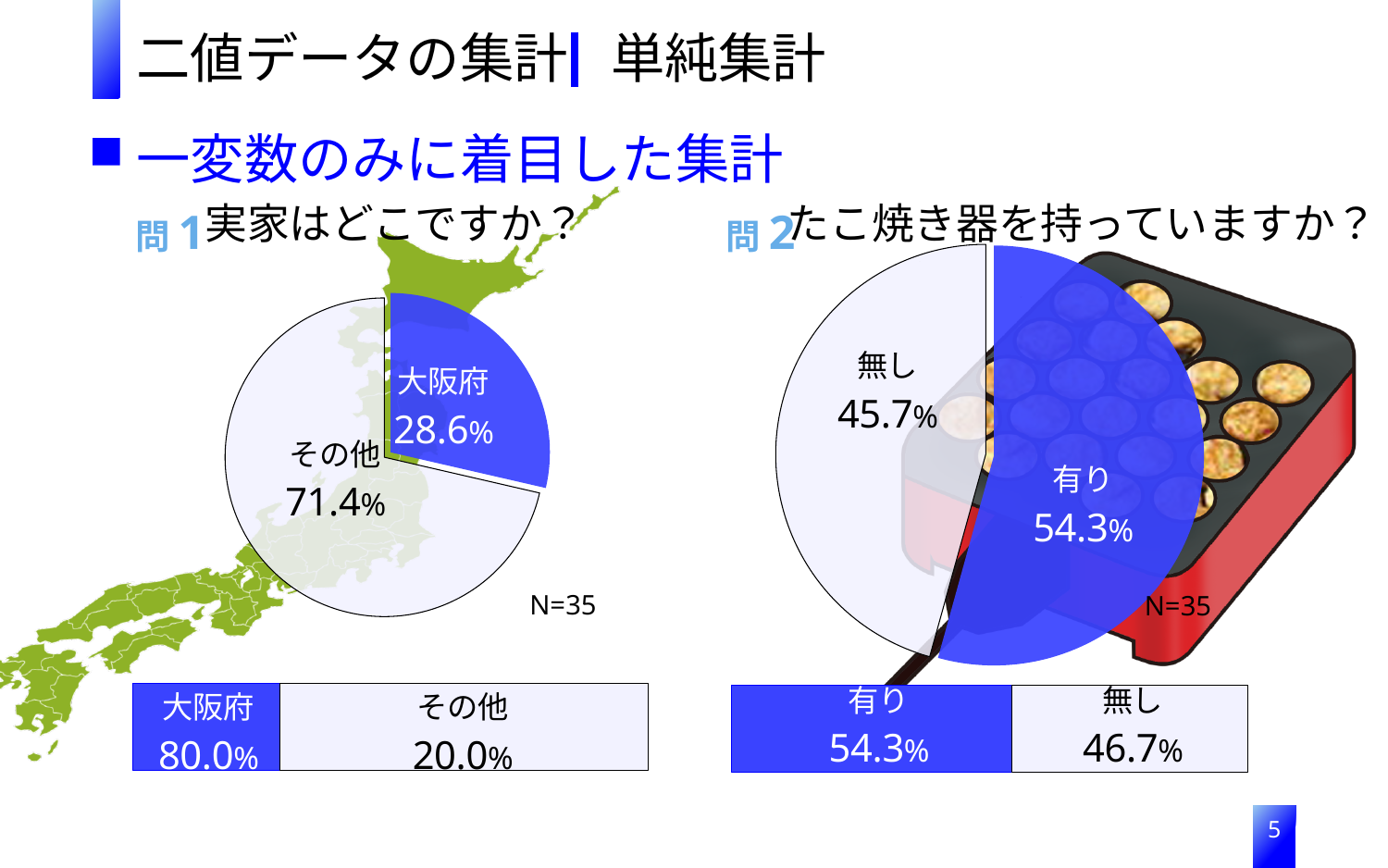
In the 問1 pie chart (実家はどこですか？), what is the value for 大阪府? 28.6% In the 問2 pie chart (たこ焼き器を持っていますか？), what is the value for 有り? 54.3% In the 問2 pie chart (たこ焼き器を持っていますか？), what is the value for 無し? 45.7% In the 問1 pie chart, what is the difference between その他 and 大阪府? 42.8% In the 問2 pie chart, which category has the smallest share? 無し In the horizontal bar chart at the bottom left (below 問1), what is the value for 大阪府? 80.0% In the 問1 pie chart (実家はどこですか？), what is the value for その他? 71.4% What type of chart is used for 問1 (実家はどこですか？)? Pie chart What sample size (N) is shown for the 問2 pie chart? N=35 In the 問1 pie chart, which category has the largest share? その他 In the horizontal bar chart at the bottom right (below 問2), what is the value for 無し? 46.7% In the 問2 pie chart, is 有り or 無し larger? 有り